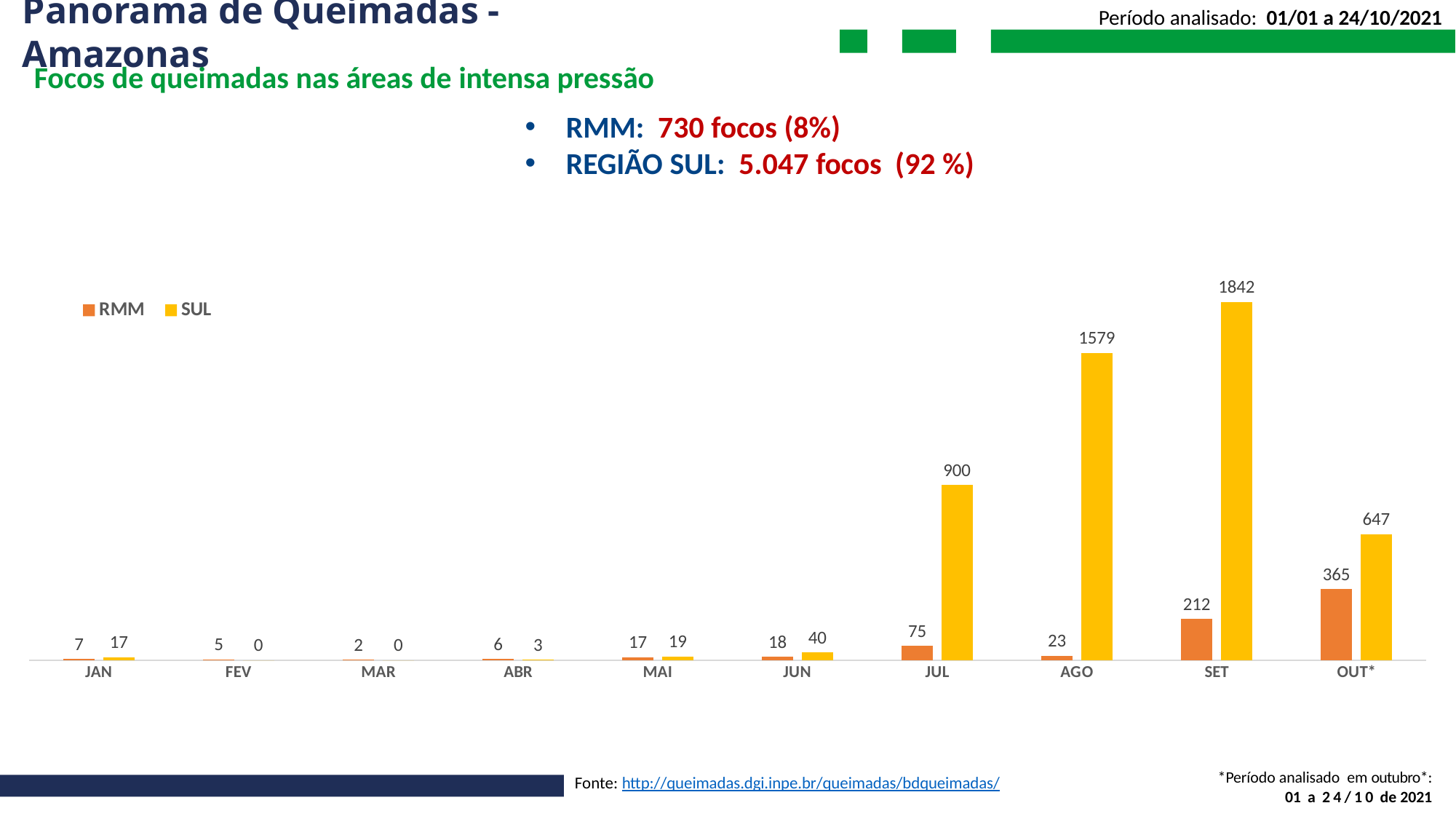
What is the RMM value for AGO? 23 What colour are the SUL bars? yellow What is the RMM value for OUT*? 365 Which month has the highest SUL value? SET What is the SUL value for JUL? 900 How many months are shown on the x axis? 10 What is the SUL value for SET? 1842 What is the difference between the SUL values for SET and AGO? 263 How many series does the legend list? 2 Which is larger, the RMM value for SET or the RMM value for OUT*? OUT* What kind of chart is shown on the slide? bar chart Which month has the lowest SUL value? FEV and MAR (both 0)